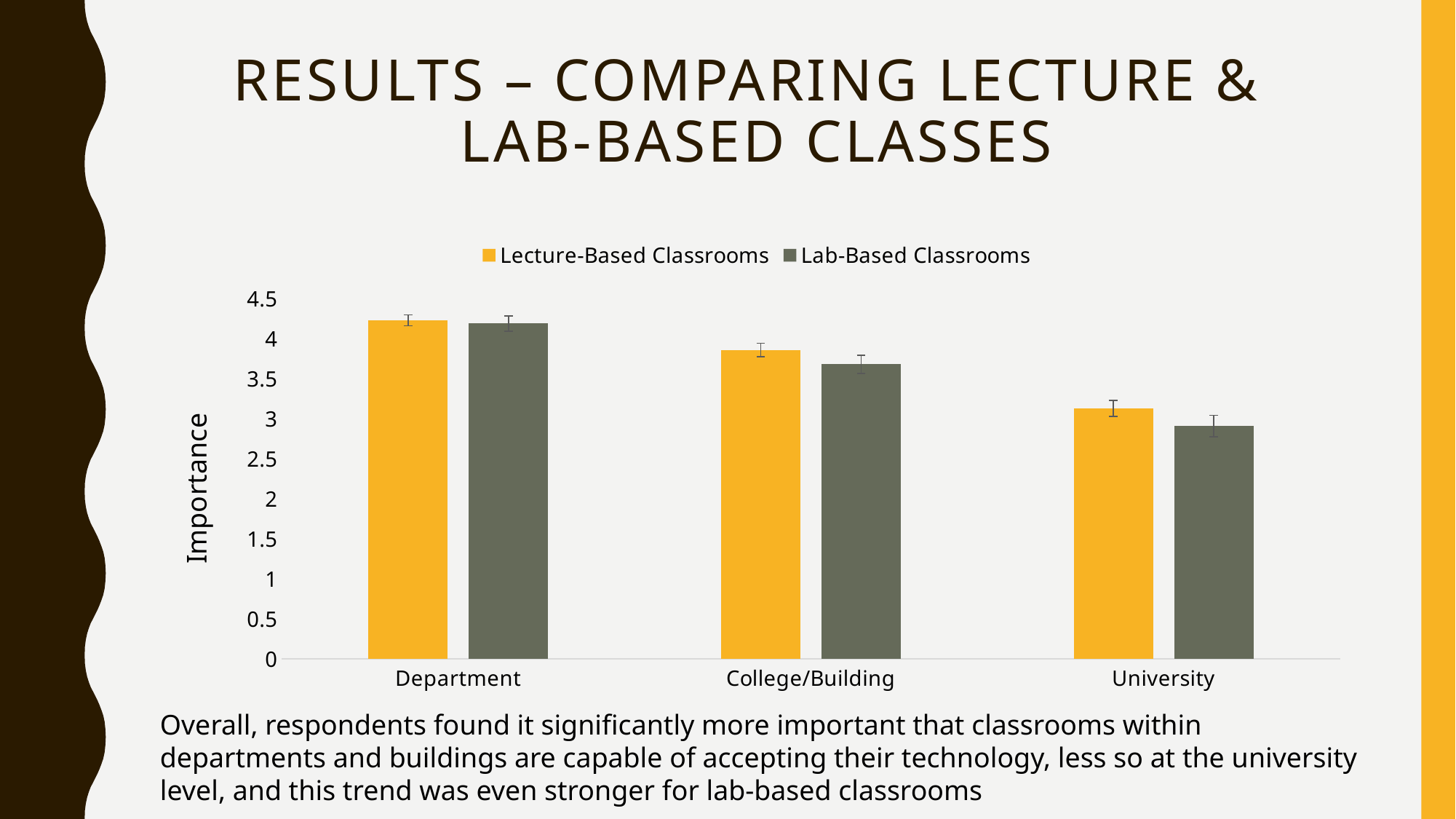
Which category has the lowest value for Lab-Based Classrooms? University Which category has the highest value for Lecture-Based Classrooms? Department How many series does the legend list? 2 For College/Building, which series has the larger value: Lecture-Based Classrooms or Lab-Based Classrooms? Lecture-Based Classrooms For University, which series has the larger value: Lecture-Based Classrooms or Lab-Based Classrooms? Lecture-Based Classrooms What kind of chart is shown on the slide? bar chart Is the value for Lab-Based Classrooms at College/Building greater or less than 3.5? greater What is the label on the y axis? Importance Is the value for Lecture-Based Classrooms at Department greater or less than 4? greater Is the value for Lab-Based Classrooms at University greater or less than 3? less How many categories are shown on the x axis? 3 Do the Lecture-Based Classrooms values rise or fall from Department to University along the x axis? fall